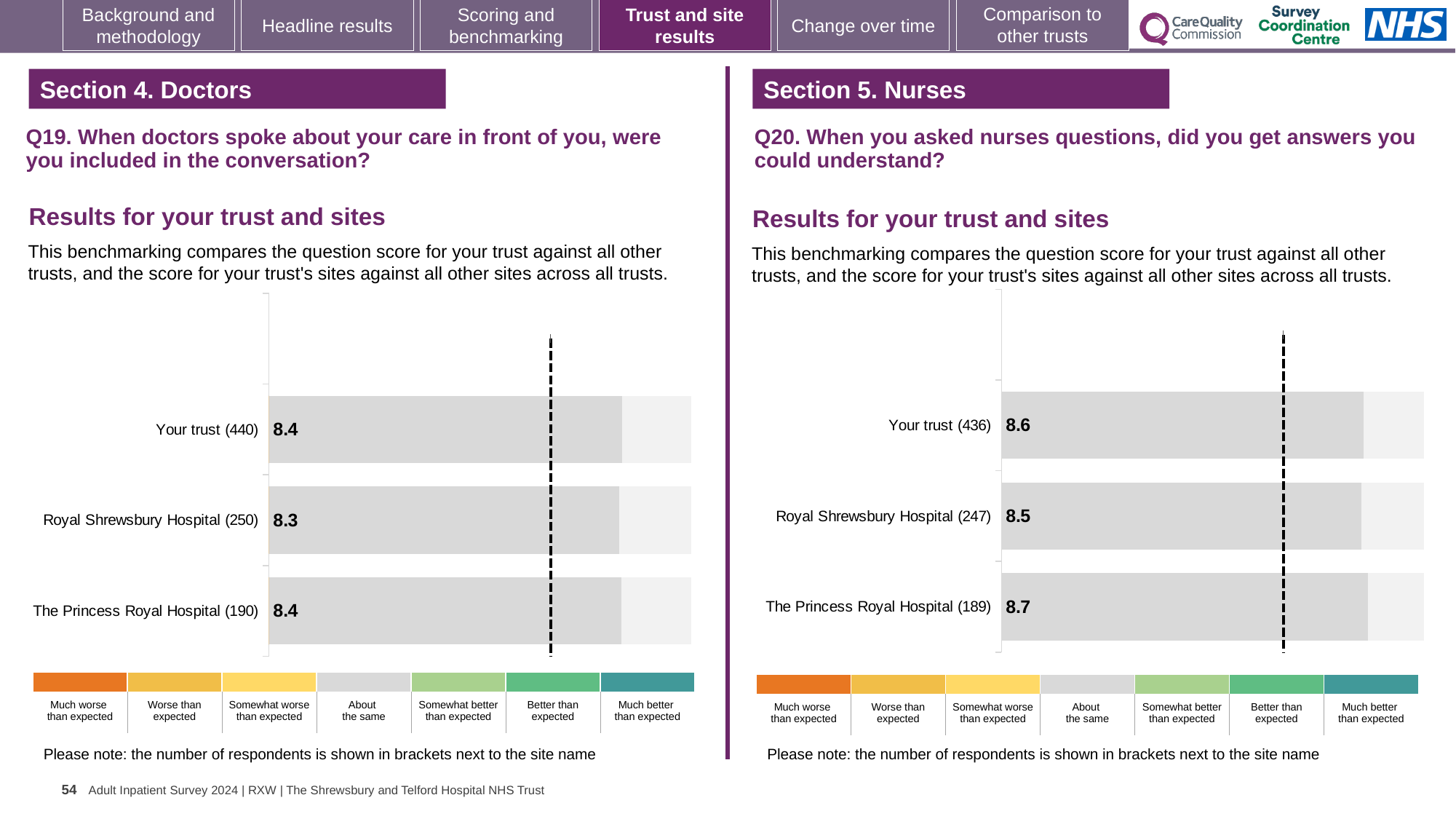
In the Q19 chart (Section 4. Doctors), which has the larger score: Your trust (440) or Royal Shrewsbury Hospital (250)? Your trust (440) In the Q20 chart (Section 5. Nurses), what is the difference between the scores for The Princess Royal Hospital (189) and Royal Shrewsbury Hospital (247)? 0.2 How many benchmark categories are shown in the colour key below the Q19 chart (Section 4. Doctors)? 7 In the Q19 chart (Section 4. Doctors), which site has the lowest score? Royal Shrewsbury Hospital (250) In the Q19 chart (Section 4. Doctors), what is the score for Your trust (440)? 8.4 How many bars are plotted in the Q19 chart (Section 4. Doctors)? 3 In the Q20 chart (Section 5. Nurses), what is the score for The Princess Royal Hospital (189)? 8.7 In the Q20 chart (Section 5. Nurses), which site or trust has the lowest score? Royal Shrewsbury Hospital (247) In the Q20 chart (Section 5. Nurses), which site or trust has the highest score? The Princess Royal Hospital (189) What kind of chart is used in the Q20 chart (Section 5. Nurses)? Bar chart In the Q20 chart (Section 5. Nurses), what is the score for Your trust (436)? 8.6 In the Q19 chart (Section 4. Doctors), what is the score for Royal Shrewsbury Hospital (250)? 8.3